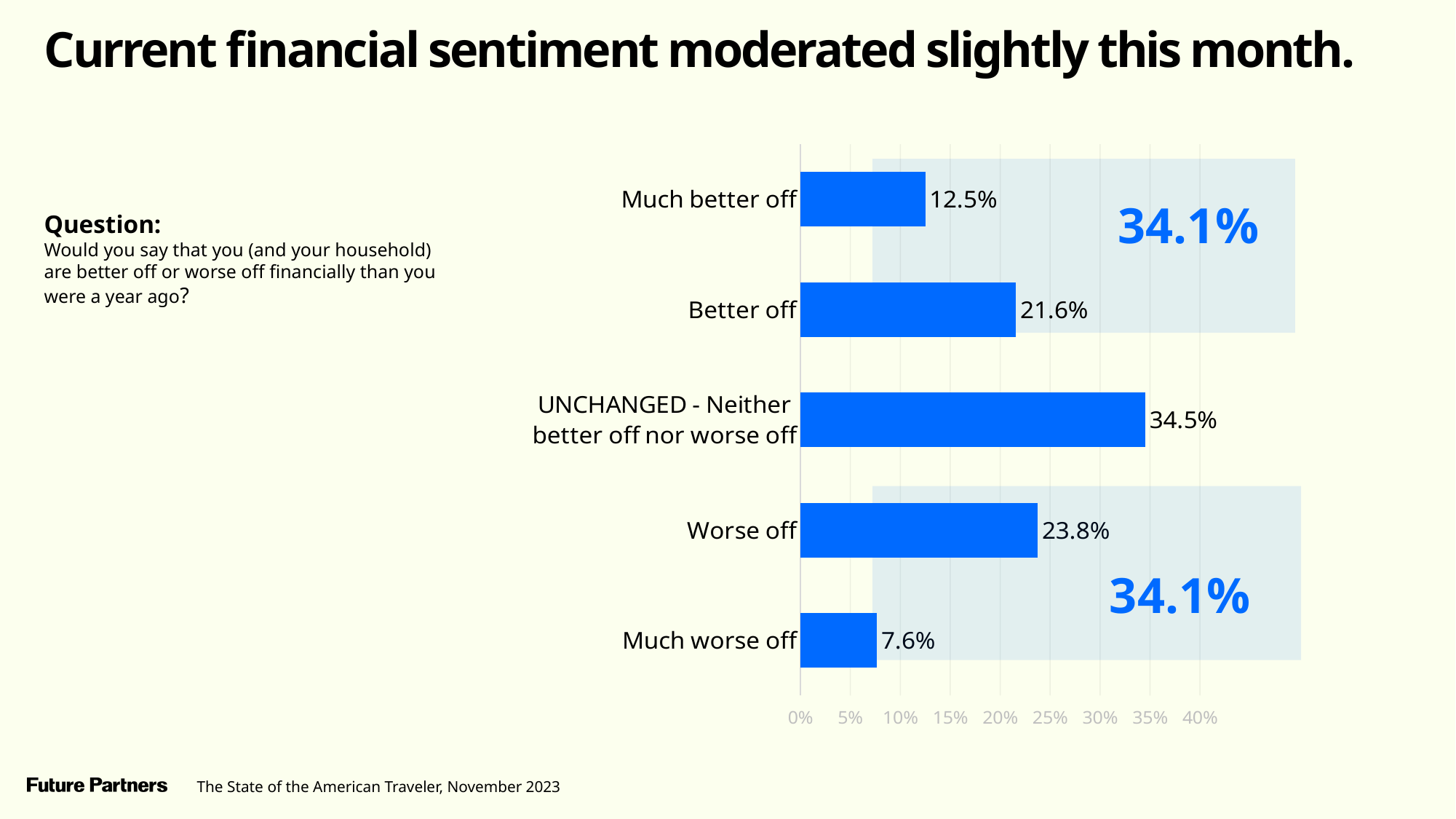
What is the combined total of "Much better off" and "Better off" as shown in the highlighted box? 34.1% Which is larger, the value for "Much better off" or the value for "Much worse off"? Much better off Which category has the highest value? UNCHANGED - Neither better off nor worse off What percentage of respondents said they are "Much worse off"? 7.6% How many categories are shown in the chart? 5 What is the difference between the "Worse off" and "Better off" values? 2.2% What percentage of respondents said they are "Much better off"? 12.5% Which category has the lowest value? Much worse off What is the combined total of "Worse off" and "Much worse off" as shown in the highlighted box? 34.1% What percentage of respondents said they are "Worse off"? 23.8% Is the value for "Better off" greater or less than 20%? greater What kind of chart is shown on the slide? Bar chart